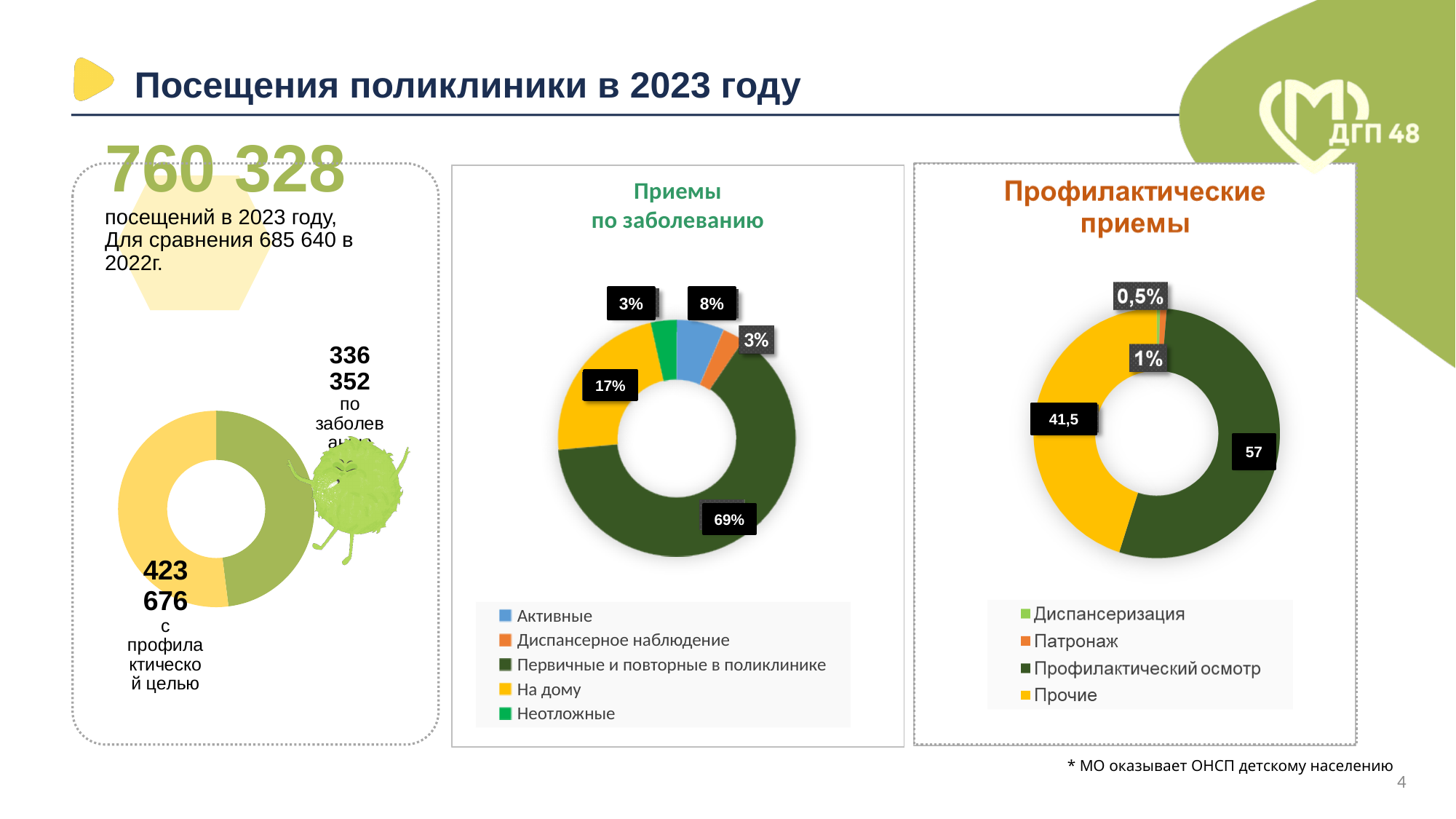
On the chart titled 'Приемы по заболеванию', what share is labelled for 'Первичные и повторные в поликлинике'? 69% On the donut chart at the left of the slide, what value is shown for visits 'по заболеванию'? 336 352 On the chart titled 'Приемы по заболеванию', what share is labelled for 'Активные'? 8% On the chart titled 'Приемы по заболеванию', which category has the largest share? Первичные и повторные в поликлинике On the chart titled 'Профилактические приемы', what value is labelled for 'Прочие'? 41,5 On the chart titled 'Профилактические приемы', which category has the smallest share? Диспансеризация On the chart titled 'Профилактические приемы', which is larger: 'Патронаж' or 'Диспансеризация'? Патронаж On the chart titled 'Приемы по заболеванию', what share is labelled for 'На дому'? 17% On the chart titled 'Профилактические приемы', what value is labelled for 'Профилактический осмотр'? 57 What type of chart is used for 'Профилактические приемы'? Donut (pie) chart On the chart titled 'Приемы по заболеванию', what is the difference between the shares for 'На дому' and 'Активные'? 9% On the chart titled 'Приемы по заболеванию', how many categories does the legend list? 5